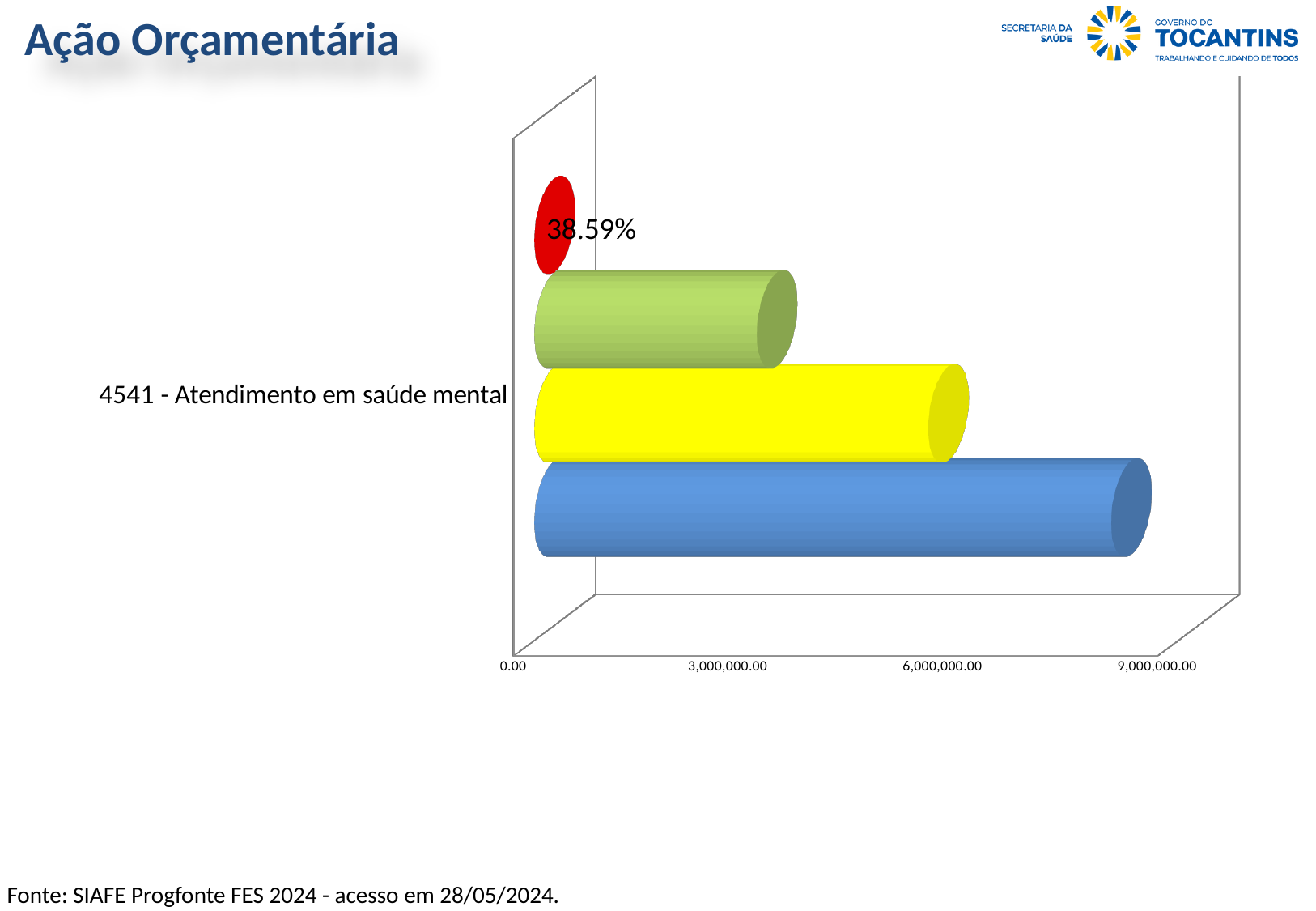
How many bars are plotted for the category on the chart? 4 Is the value of the blue bar greater or less than 6,000,000.00? greater What kind of chart is shown on the slide? bar chart Which coloured bar is the shortest on the chart? red Is the value of the yellow bar greater or less than 3,000,000.00? greater Which is larger, the yellow bar or the green bar? yellow What value is printed as the data label on the red bar? 38.59% Is the value of the green bar greater or less than 6,000,000.00? less What is the category label shown on the chart? 4541 - Atendimento em saúde mental What is the highest tick value shown on the value axis? 9,000,000.00 How many categories are shown on the chart's category axis? 1 Which coloured bar is the longest on the chart? blue